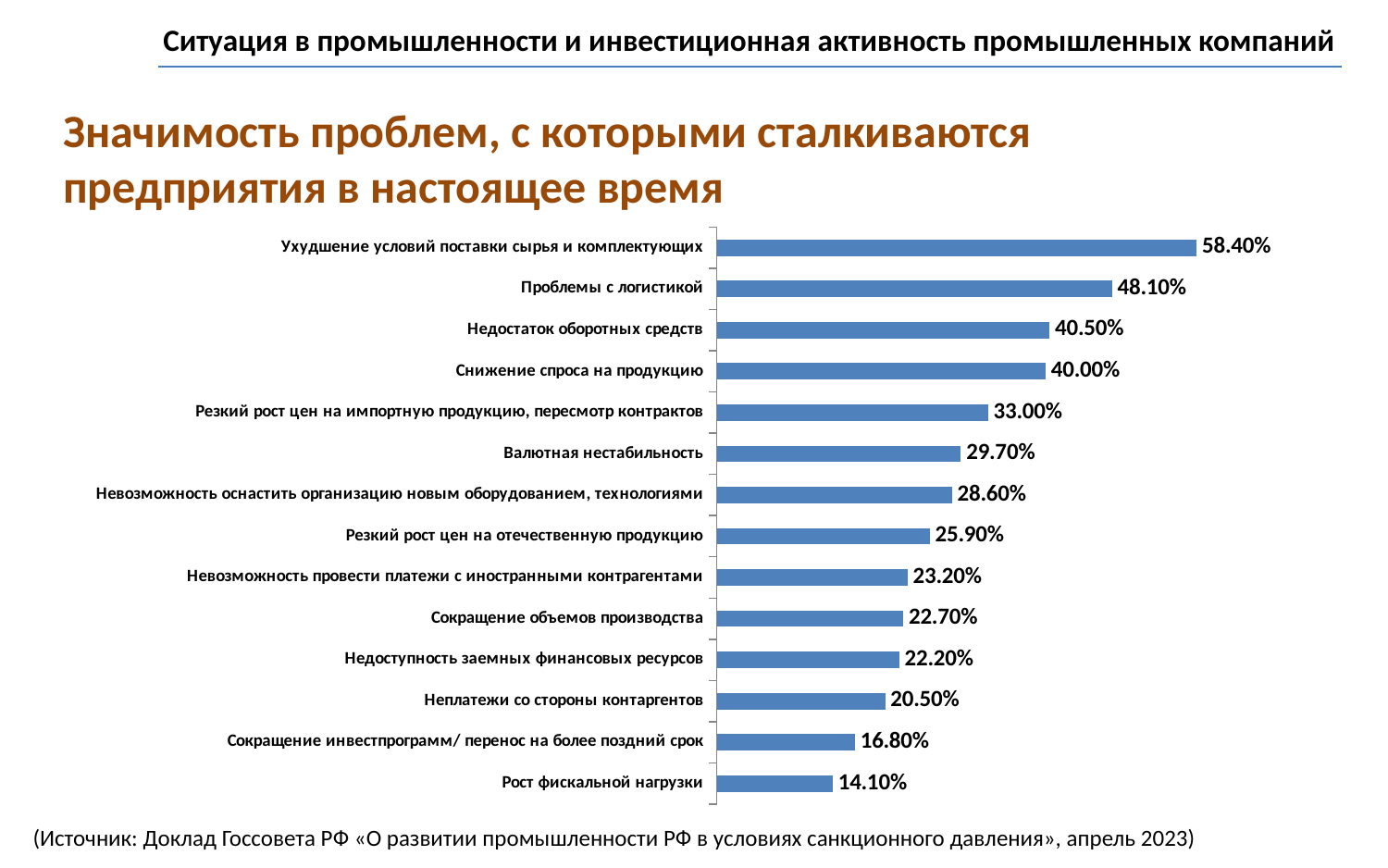
What is the value for «Валютная нестабильность»? 29.70% What is the value for «Рост фискальной нагрузки»? 14.10% Which is larger: «Резкий рост цен на импортную продукцию, пересмотр контрактов» or «Резкий рост цен на отечественную продукцию»? Резкий рост цен на импортную продукцию, пересмотр контрактов How many categories are shown in the chart? 14 Which category has the lowest value? Рост фискальной нагрузки What kind of chart is shown on the slide? Bar chart What is the value for «Проблемы с логистикой»? 48.10% What is the value for «Сокращение инвестпрограмм/ перенос на более поздний срок»? 16.80% What is the difference between «Недостаток оборотных средств» and «Снижение спроса на продукцию»? 0.50% What is the difference between «Ухудшение условий поставки сырья и комплектующих» and «Проблемы с логистикой»? 10.30% Which category has the highest value? Ухудшение условий поставки сырья и комплектующих What is the title of the chart? Значимость проблем, с которыми сталкиваются предприятия в настоящее время